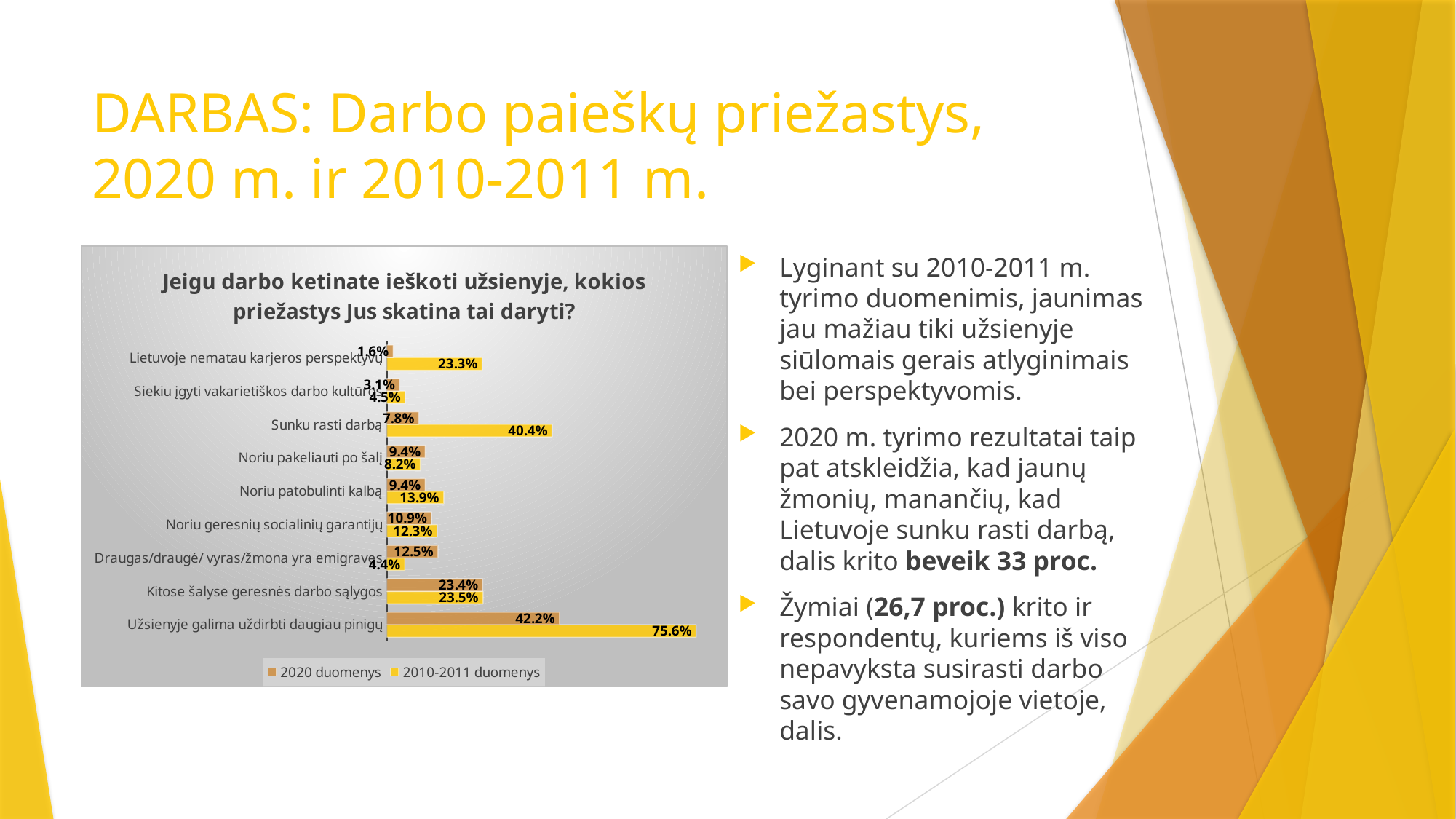
What is the difference between the 2010-2011 duomenys and 2020 duomenys values for 'Užsienyje galima uždirbti daugiau pinigų'? 33.4% What is the title of the chart? Jeigu darbo ketinate ieškoti užsienyje, kokios priežastys Jus skatina tai daryti? For 'Draugas/draugė/ vyras/žmona yra emigravęs', which series has the larger value, 2020 duomenys or 2010-2011 duomenys? 2020 duomenys What is the 2010-2011 duomenys value for 'Sunku rasti darbą'? 40.4% How many categories are shown in the chart? 9 What type of chart is shown on the slide? bar chart What is the 2020 duomenys value for 'Lietuvoje nematau karjeros perspektyvų'? 1.6% How many series does the chart legend list? 2 Which category has the lowest 2020 duomenys value? Lietuvoje nematau karjeros perspektyvų What is the 2020 duomenys value for 'Užsienyje galima uždirbti daugiau pinigų'? 42.2% What is the difference between the 2010-2011 duomenys and 2020 duomenys values for 'Sunku rasti darbą'? 32.6% Which category has the highest 2010-2011 duomenys value? Užsienyje galima uždirbti daugiau pinigų